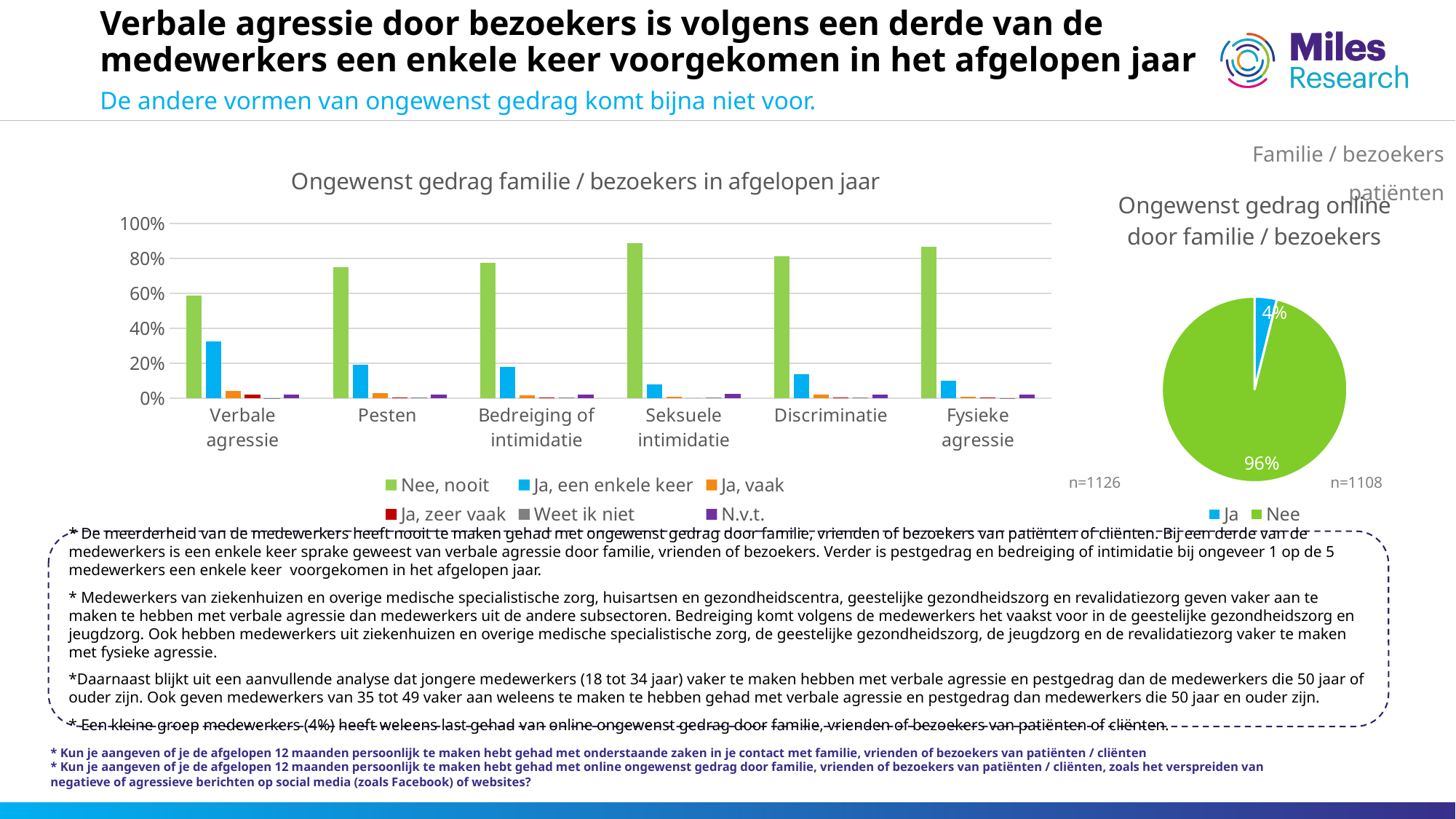
In the bar chart 'Ongewenst gedrag familie / bezoekers in afgelopen jaar', how many categories are shown on the x axis? 6 In the pie chart 'Ongewenst gedrag online door familie / bezoekers', what is the difference between the 'Nee' and 'Ja' shares? 92% In the bar chart 'Ongewenst gedrag familie / bezoekers in afgelopen jaar', which category has the highest value for 'Ja, een enkele keer'? Verbale agressie In the pie chart 'Ongewenst gedrag online door familie / bezoekers', what share is 'Ja'? 4% In the bar chart 'Ongewenst gedrag familie / bezoekers in afgelopen jaar', how many series does the legend list? 6 In the bar chart 'Ongewenst gedrag familie / bezoekers in afgelopen jaar', which category has the lowest value for 'Nee, nooit'? Verbale agressie In the bar chart 'Ongewenst gedrag familie / bezoekers in afgelopen jaar', which has the larger 'Ja, een enkele keer' value: Pesten or Seksuele intimidatie? Pesten In the bar chart 'Ongewenst gedrag familie / bezoekers in afgelopen jaar', is the 'Ja, een enkele keer' value for Verbale agressie greater or less than 20%? greater What type of chart is the chart titled 'Ongewenst gedrag online door familie / bezoekers'? pie chart What type of chart is the chart titled 'Ongewenst gedrag familie / bezoekers in afgelopen jaar'? bar chart In the pie chart 'Ongewenst gedrag online door familie / bezoekers', what is the value for 'Nee'? 96% In the bar chart 'Ongewenst gedrag familie / bezoekers in afgelopen jaar', is the 'Nee, nooit' value for Seksuele intimidatie greater or less than 80%? greater